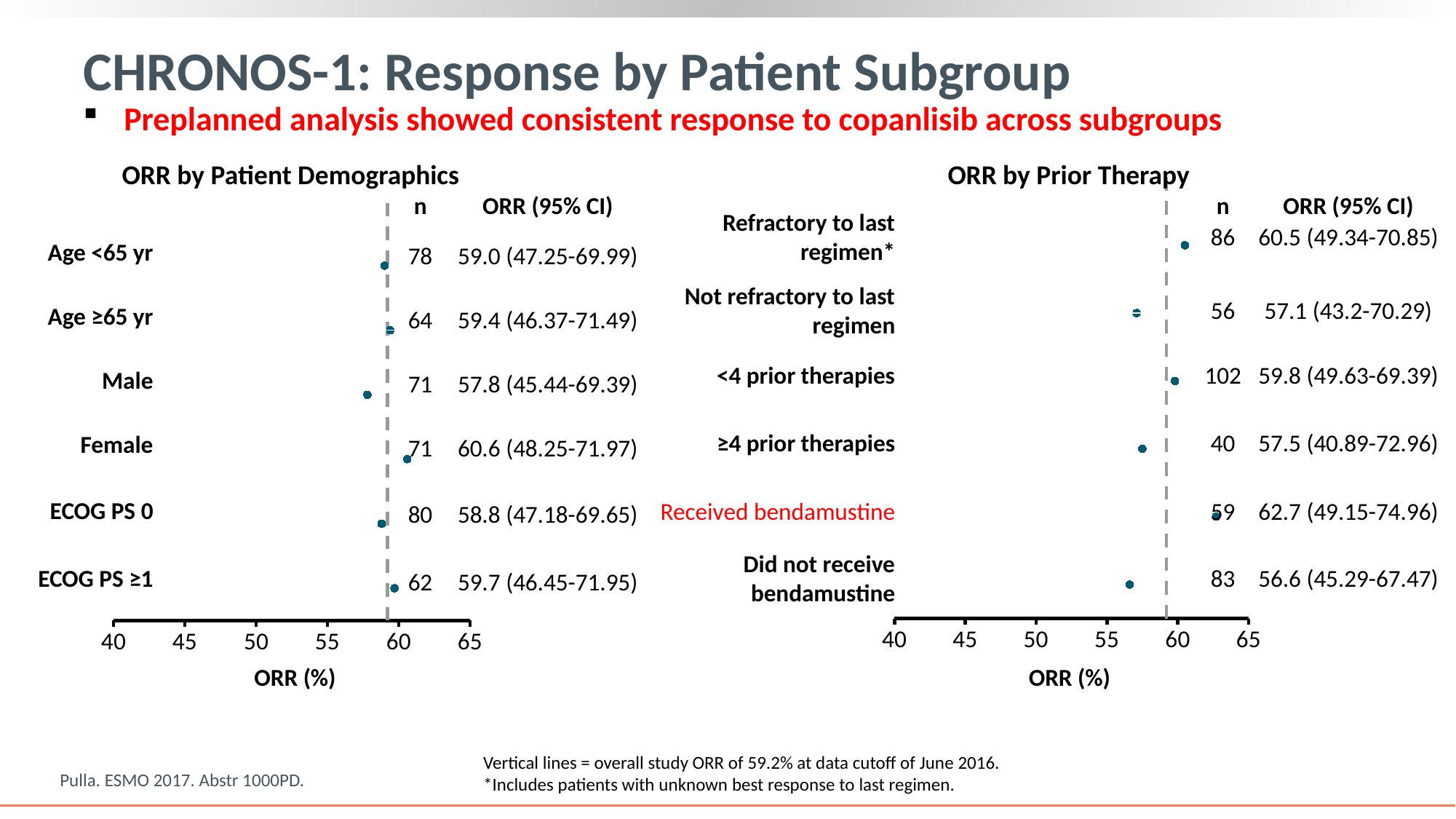
In the ORR by Patient Demographics chart, how many subgroups are plotted? 6 In the ORR by Patient Demographics chart, what is the n for the ECOG PS 0 subgroup? 80 In the ORR by Prior Therapy chart, which subgroup has the highest ORR? Received bendamustine In the ORR by Prior Therapy chart, which subgroup has the lowest ORR? Did not receive bendamustine What value do the vertical dashed lines in both charts represent? Overall study ORR of 59.2% In the ORR by Patient Demographics chart, what is the difference in ORR between the Female and Male subgroups? 2.8 In the ORR by Prior Therapy chart, what is the ORR for patients who received bendamustine? 62.7 In the ORR by Prior Therapy chart, what is the n for the <4 prior therapies subgroup? 102 In the ORR by Prior Therapy chart, what is the difference in ORR between patients who received bendamustine and those who did not? 6.1 In the ORR by Patient Demographics chart, what is the ORR for the Female subgroup? 60.6 In the ORR by Prior Therapy chart, which has a higher ORR: Refractory to last regimen or Not refractory to last regimen? Refractory to last regimen In the ORR by Patient Demographics chart, which subgroup has the lowest ORR? Male